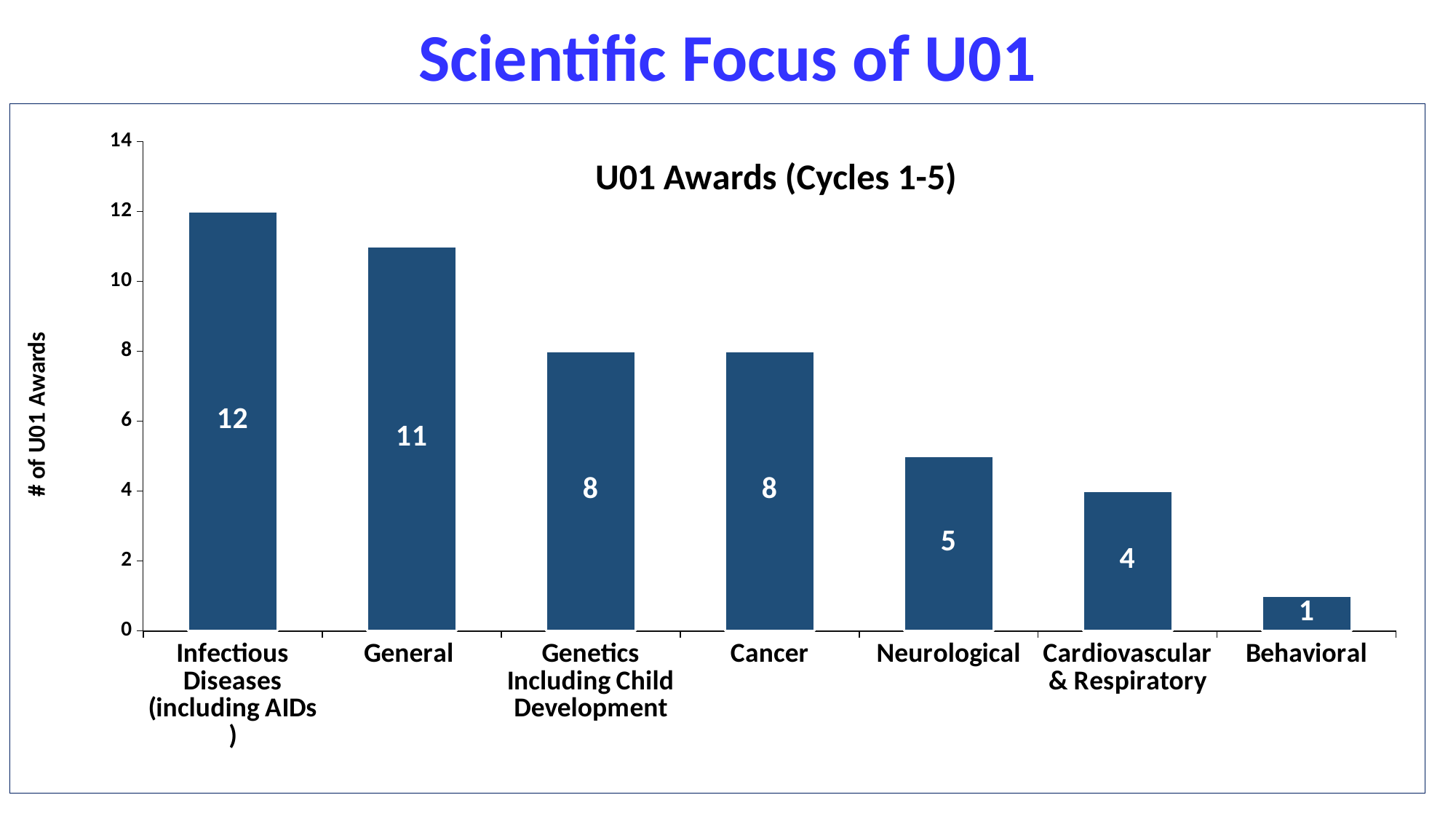
What kind of chart is shown on the slide? Bar chart What is the difference in U01 awards between General and Cancer? 3 How many U01 awards are shown for Cardiovascular & Respiratory? 4 How many categories are shown on the x axis of the chart? 7 What is the number of U01 awards for Neurological? 5 Is the value for General greater or less than 10? greater Which category has the lowest number of U01 awards? Behavioral Which has more U01 awards, Neurological or Cardiovascular & Respiratory? Neurological What is the title of the chart? U01 Awards (Cycles 1-5) What is the difference in U01 awards between Infectious Diseases (including AIDs) and Behavioral? 11 How many U01 awards does the chart show for Infectious Diseases (including AIDs)? 12 Which category has the highest number of U01 awards? Infectious Diseases (including AIDs)